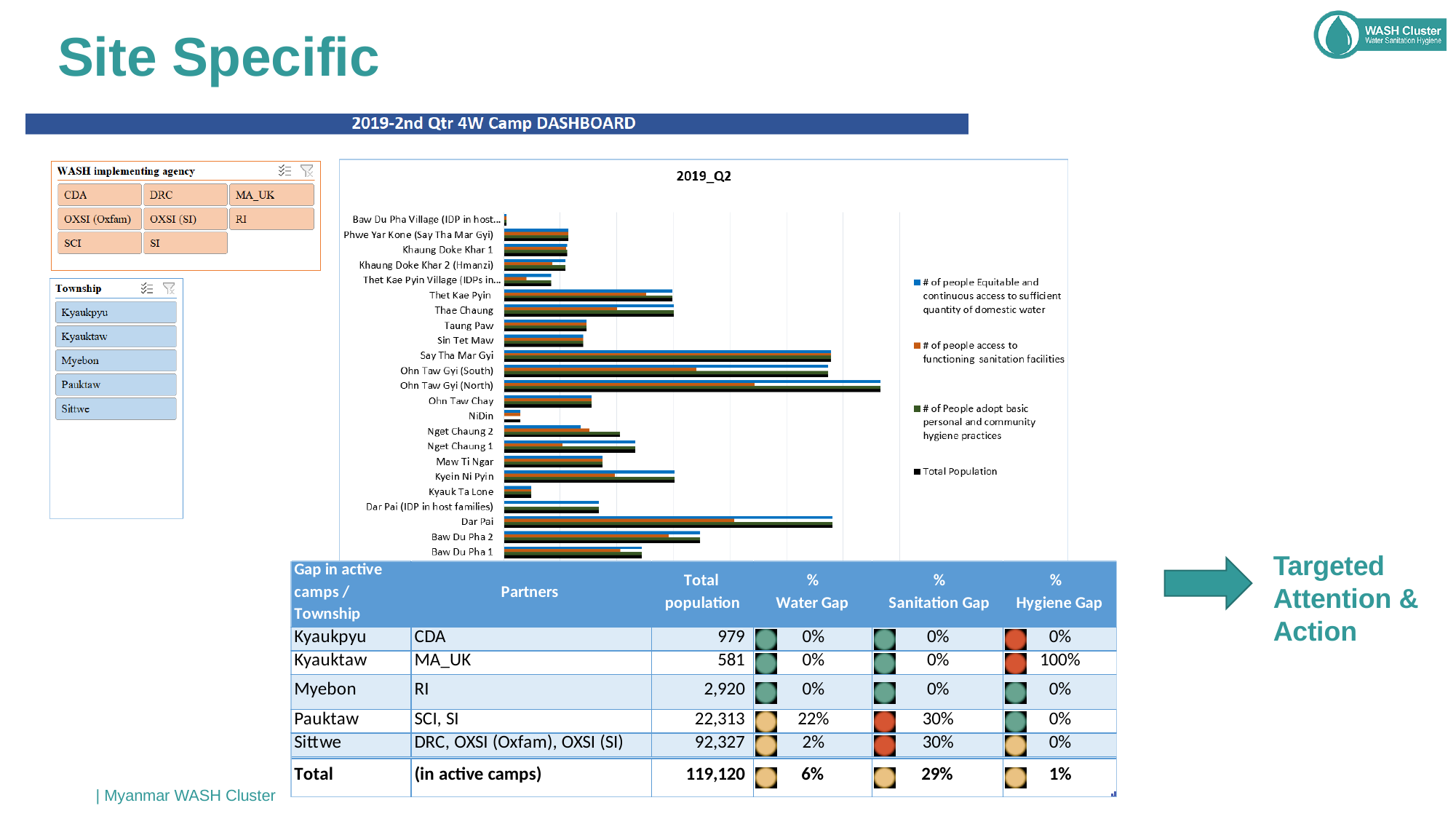
In the 2019_Q2 chart, which has the larger Total Population bar: Say Tha Mar Gyi or Taung Paw? Say Tha Mar Gyi In the 2019_Q2 chart, which has the larger Total Population bar: NiDin or Dar Pai? Dar Pai In the 2019_Q2 chart, which has the larger Total Population bar: Kyauk Ta Lone or Kyein Ni Pyin? Kyein Ni Pyin What kind of chart is shown under the title 2019_Q2? bar chart How many camps (categories) are plotted on the 2019_Q2 chart? 23 How many series does the legend of the 2019_Q2 chart list? 4 Which camp has the largest Total Population bar in the 2019_Q2 chart? Ohn Taw Gyi (North) Which camp has the smallest bars in the 2019_Q2 chart? Baw Du Pha Village (IDP in host...) Which series in the 2019_Q2 chart is shown in black? Total Population What is the title of the bar chart on the slide? 2019_Q2